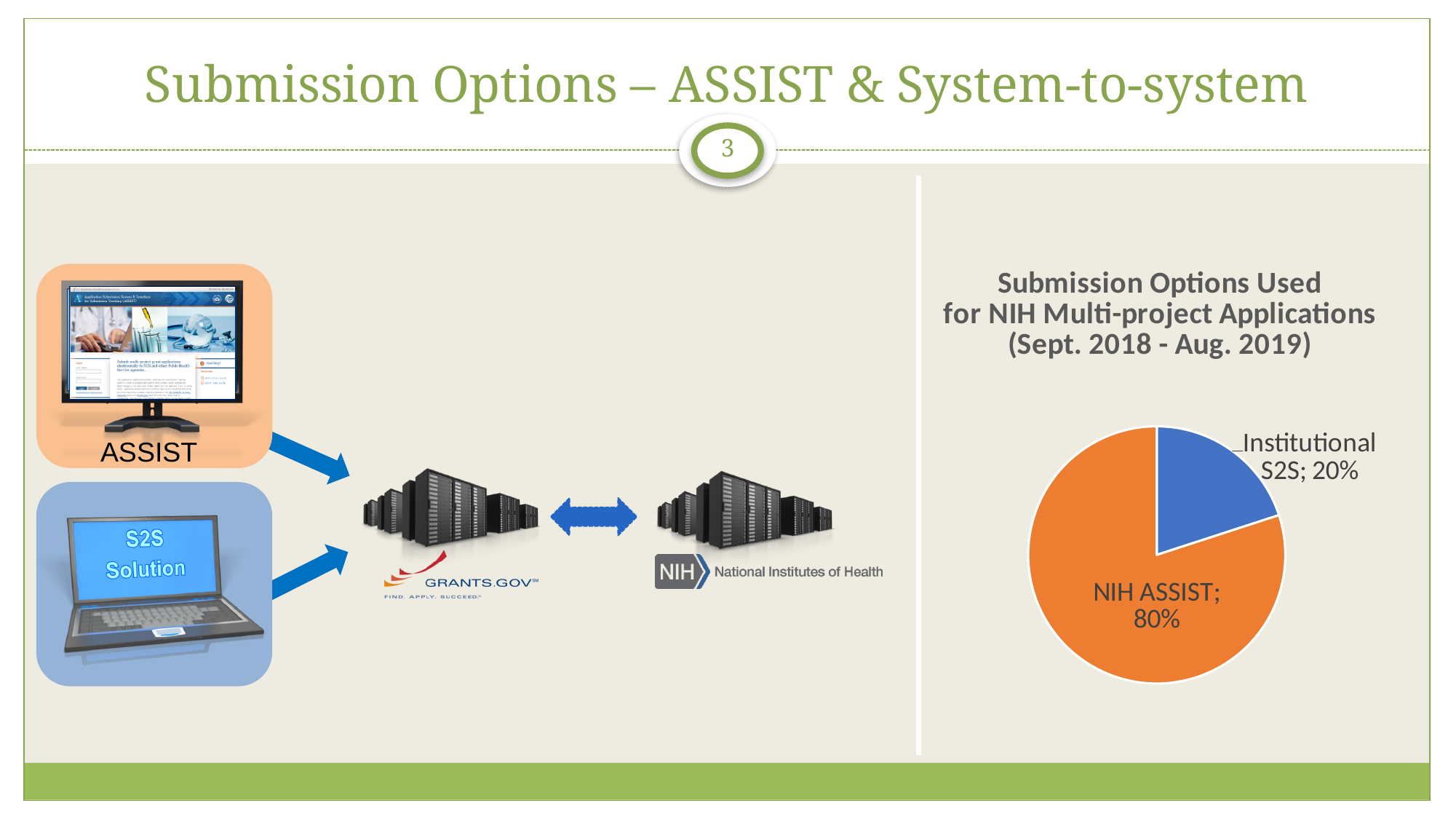
What share of the pie is Institutional S2S? 20% What time period does the pie chart cover? Sept. 2018 - Aug. 2019 What kind of chart is shown on the slide? pie chart Which is larger, the share for NIH ASSIST or the share for Institutional S2S? NIH ASSIST Which submission option has the largest share of the pie? NIH ASSIST How many slices does the pie chart have? 2 Which submission option has the smallest share of the pie? Institutional S2S What colour is the NIH ASSIST slice of the pie chart? orange What is the title of the pie chart? Submission Options Used for NIH Multi-project Applications (Sept. 2018 - Aug. 2019) What is the difference in percentage points between the NIH ASSIST share and the Institutional S2S share? 60 What share of the pie is NIH ASSIST? 80%